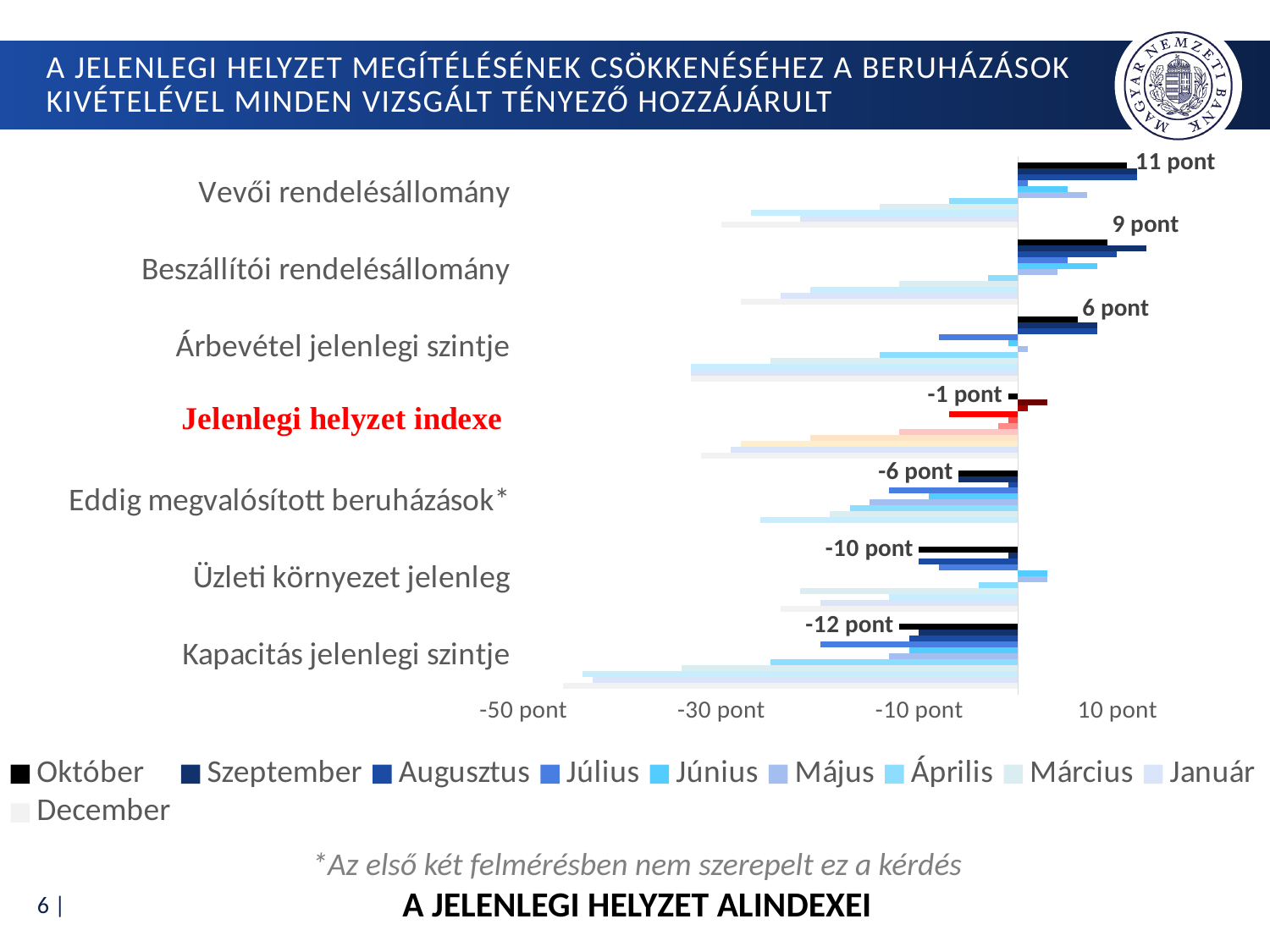
Which category has the lowest Október value? Kapacitás jelenlegi szintje What is the difference between the Október values for Vevői rendelésállomány and Beszállítói rendelésállomány? 2 pont How many categories are shown on the chart? 7 Which has a larger Október value, Árbevétel jelenlegi szintje or Eddig megvalósított beruházások*? Árbevétel jelenlegi szintje What is the Október value for Jelenlegi helyzet indexe? -1 pont What is the Október value for Kapacitás jelenlegi szintje? -12 pont What kind of chart is shown on the slide? Bar chart What is the Október value for Üzleti környezet jelenleg? -10 pont Which category has the highest Október value? Vevői rendelésállomány How many series does the legend list? 10 Is the December value for Kapacitás jelenlegi szintje greater or less than -30 pont? less What is the Október value for Vevői rendelésállomány? 11 pont